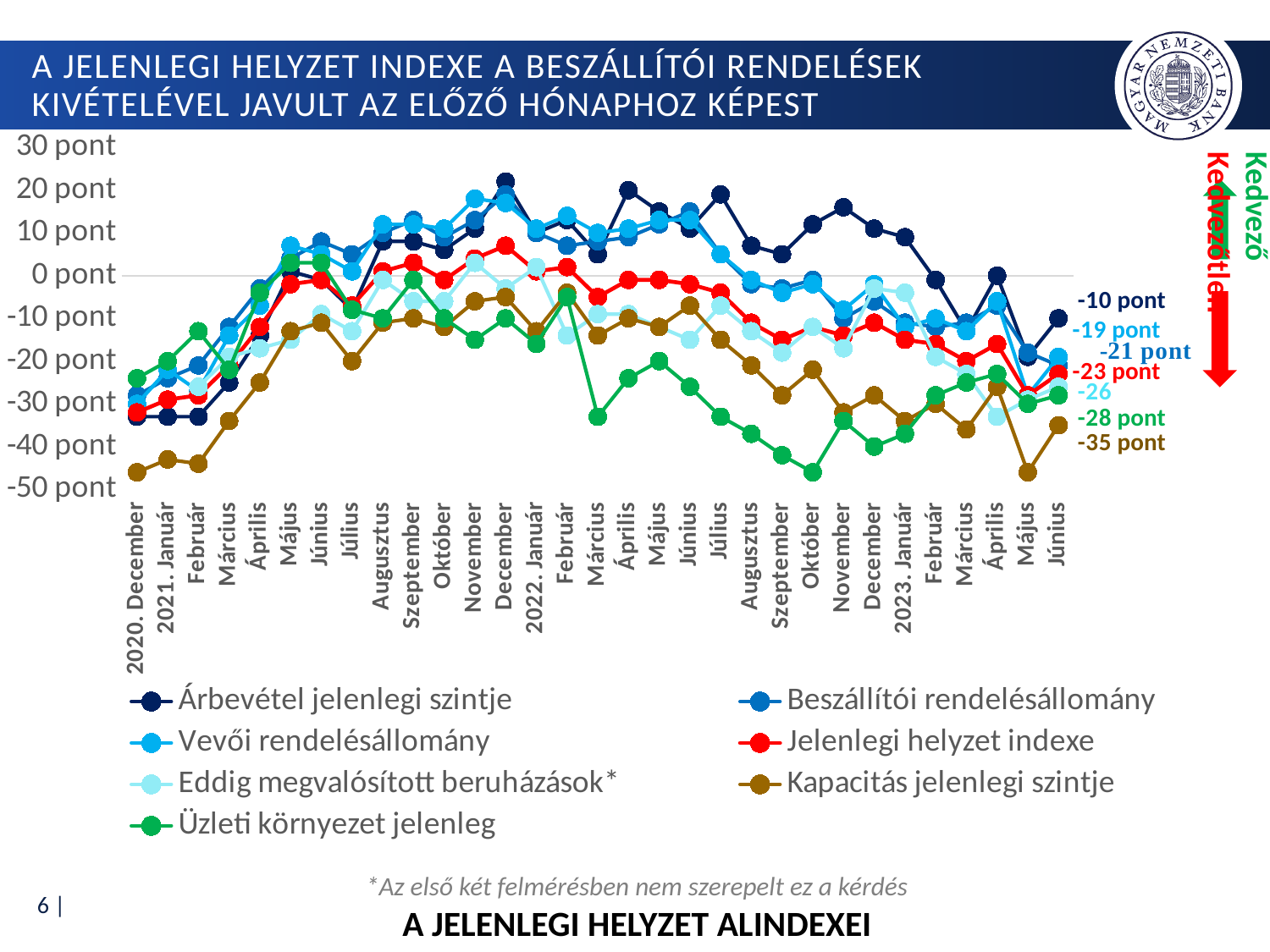
What is the value of Üzleti környezet jelenleg in 2023 Június? -28 pont What is the difference between Árbevétel jelenlegi szintje and Kapacitás jelenlegi szintje in 2023 Június? 25 pont In 2023 Június, which is larger: Jelenlegi helyzet indexe or Üzleti környezet jelenleg? Jelenlegi helyzet indexe What is the value of Kapacitás jelenlegi szintje in 2023 Június? -35 pont How many months are shown on the x axis? 31 What type of chart is shown on the slide? line chart Which series has the lowest value in 2023 Június? Kapacitás jelenlegi szintje Which series has the highest value in 2023 Június? Árbevétel jelenlegi szintje What is the value of Jelenlegi helyzet indexe in 2023 Június? -23 pont Is the value of Kapacitás jelenlegi szintje in 2020 December greater or less than -40 pont? less What is the value of Árbevétel jelenlegi szintje in 2023 Június? -10 pont How many series does the legend list? 7